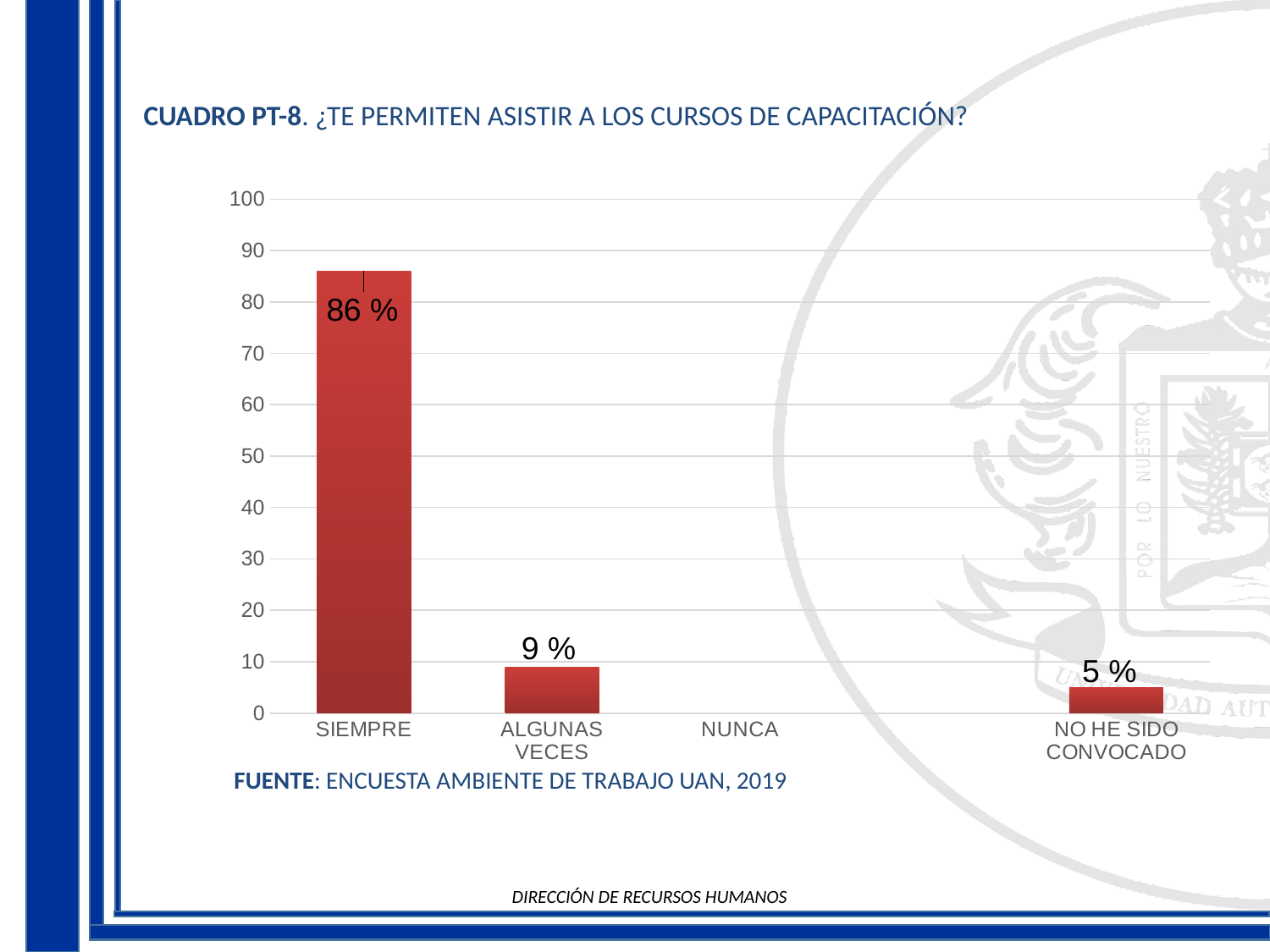
Which category has the highest value? SIEMPRE Which category has no visible bar in the chart? NUNCA What is the value for ALGUNAS VECES? 9 % How many categories are shown on the x axis? 4 Which is larger, the value for ALGUNAS VECES or the value for NO HE SIDO CONVOCADO? ALGUNAS VECES What is the difference between the values for ALGUNAS VECES and NO HE SIDO CONVOCADO? 4 % What is the value for NO HE SIDO CONVOCADO? 5 % What is the value for SIEMPRE? 86 % Is the value for SIEMPRE greater or less than 80? greater What kind of chart is shown on the slide? Bar chart Is the value for NO HE SIDO CONVOCADO greater or less than 10? less What is the difference between the values for SIEMPRE and ALGUNAS VECES? 77 %